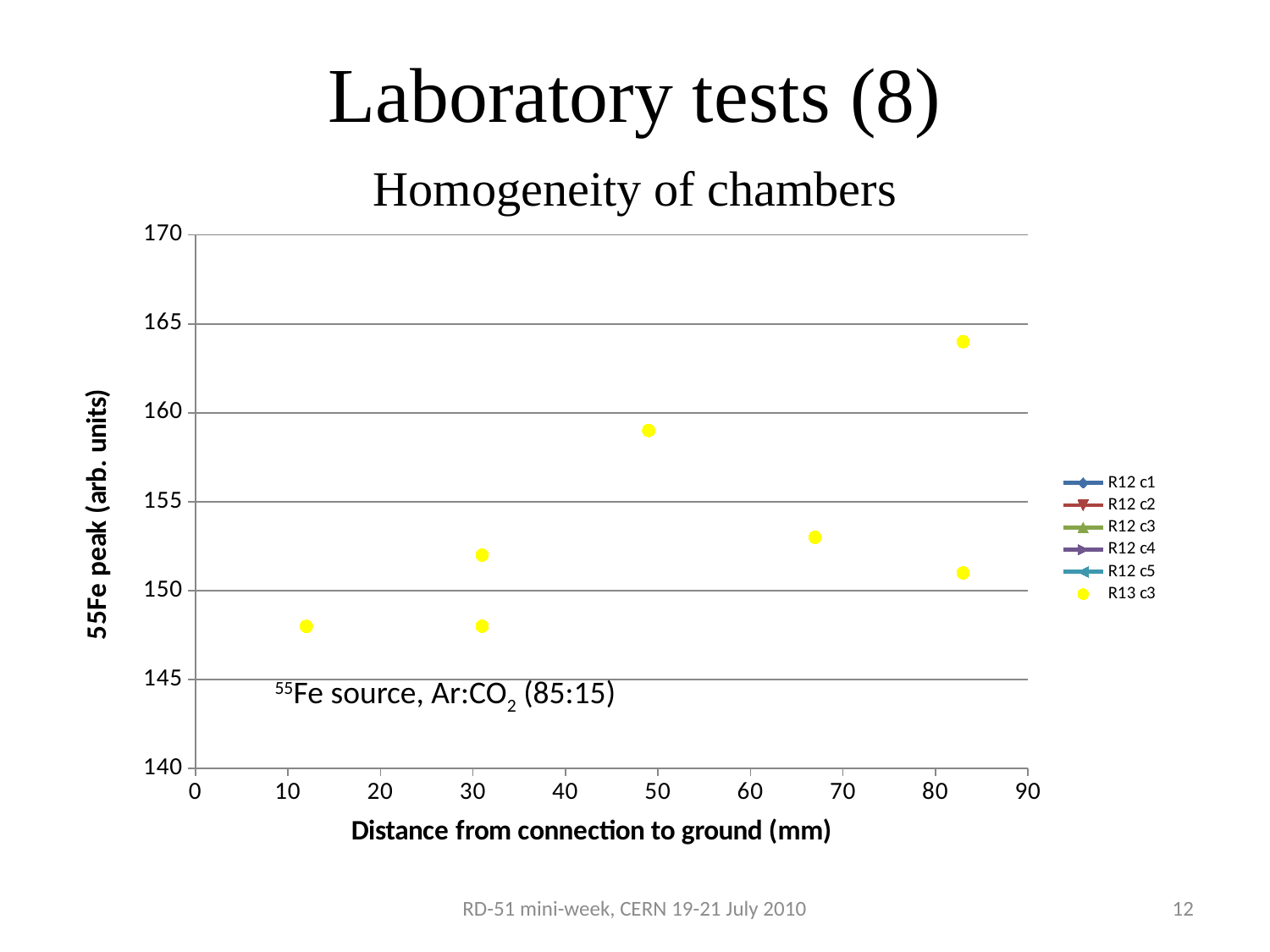
Is the value of the lowest plotted point greater or less than 145? greater Is the value of the point plotted near 49 mm greater or less than 155? greater How many data points are plotted on the chart? 7 What kind of chart is shown on the slide? scatter chart How many series does the legend list? 6 What is the title of the x axis? Distance from connection to ground (mm) Is the value of the highest plotted point (near 83 mm) greater or less than 160? greater Which series in the legend is shown with yellow circle markers? R13 c3